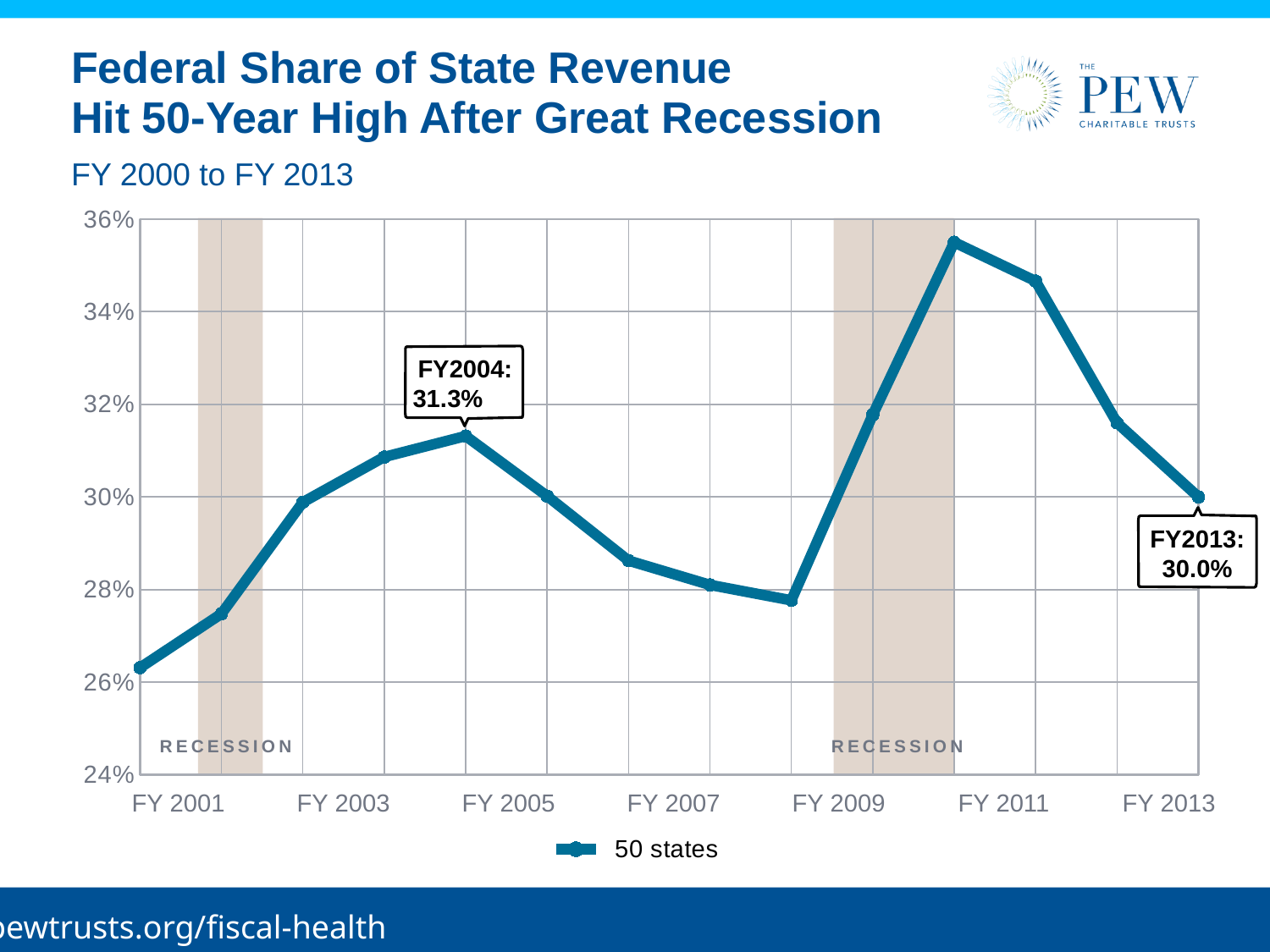
Is the value for FY 2001 greater or less than 28%? less Which is larger, the value for FY2004 or the value for FY2013? FY2004 What is the difference between the FY2004 value and the FY2013 value? 1.3 percentage points What is the value for FY2004? 31.3% Is the value for FY 2010 greater or less than 34%? greater In which fiscal year is the line at its lowest point? FY 2000 Does the line rise or fall from FY 2010 to FY 2013? Fall In which fiscal year does the line reach its highest point? FY 2010 How many series does the legend list? 1 What is the value for FY2013? 30.0% What label is shown on the shaded vertical bands in the chart? RECESSION What type of chart is shown on the slide? Line chart